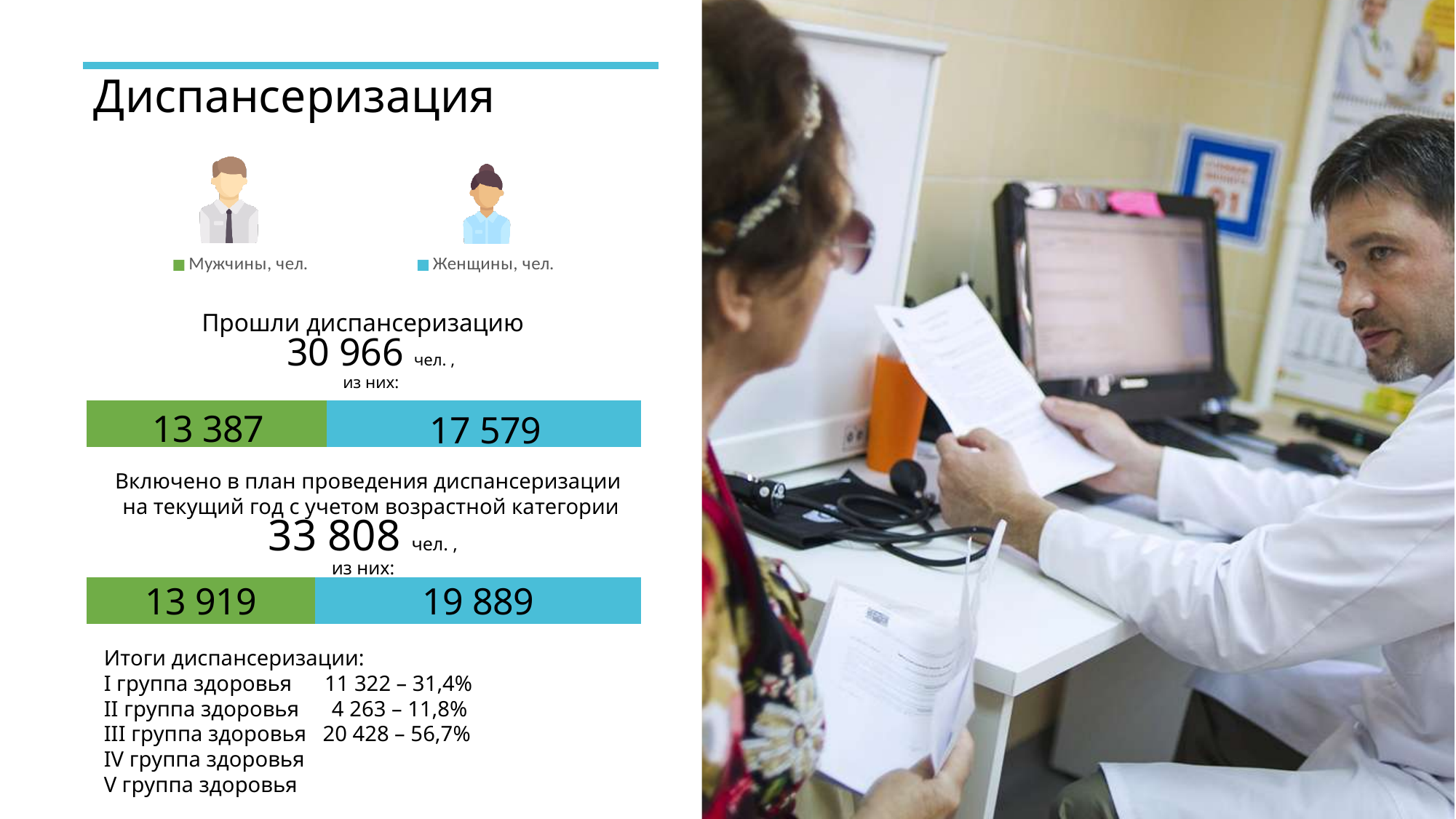
What is the total of the lower stacked bar (Включено в план проведения диспансеризации)? 33 808 How many series does the legend above the bar charts list? 2 What colour represents Мужчины, чел. in the bar charts? Green In the lower bar chart (Включено в план проведения диспансеризации), what is the difference between the Женщины and Мужчины values? 5 970 In the lower bar chart (Включено в план проведения диспансеризации), what is the value for Женщины, чел.? 19 889 In the upper bar chart (Прошли диспансеризацию), what is the value for Мужчины, чел.? 13 387 What is the total of the upper stacked bar (Прошли диспансеризацию)? 30 966 In the upper bar chart (Прошли диспансеризацию), what is the value for Женщины, чел.? 17 579 In the upper bar chart (Прошли диспансеризацию), what is the difference between the Женщины and Мужчины values? 4 192 In the upper bar chart (Прошли диспансеризацию), which series has the larger value, Мужчины or Женщины? Женщины In the lower bar chart (Включено в план проведения диспансеризации), what is the value for Мужчины, чел.? 13 919 In the lower bar chart (Включено в план проведения диспансеризации), which series has the smaller value? Мужчины